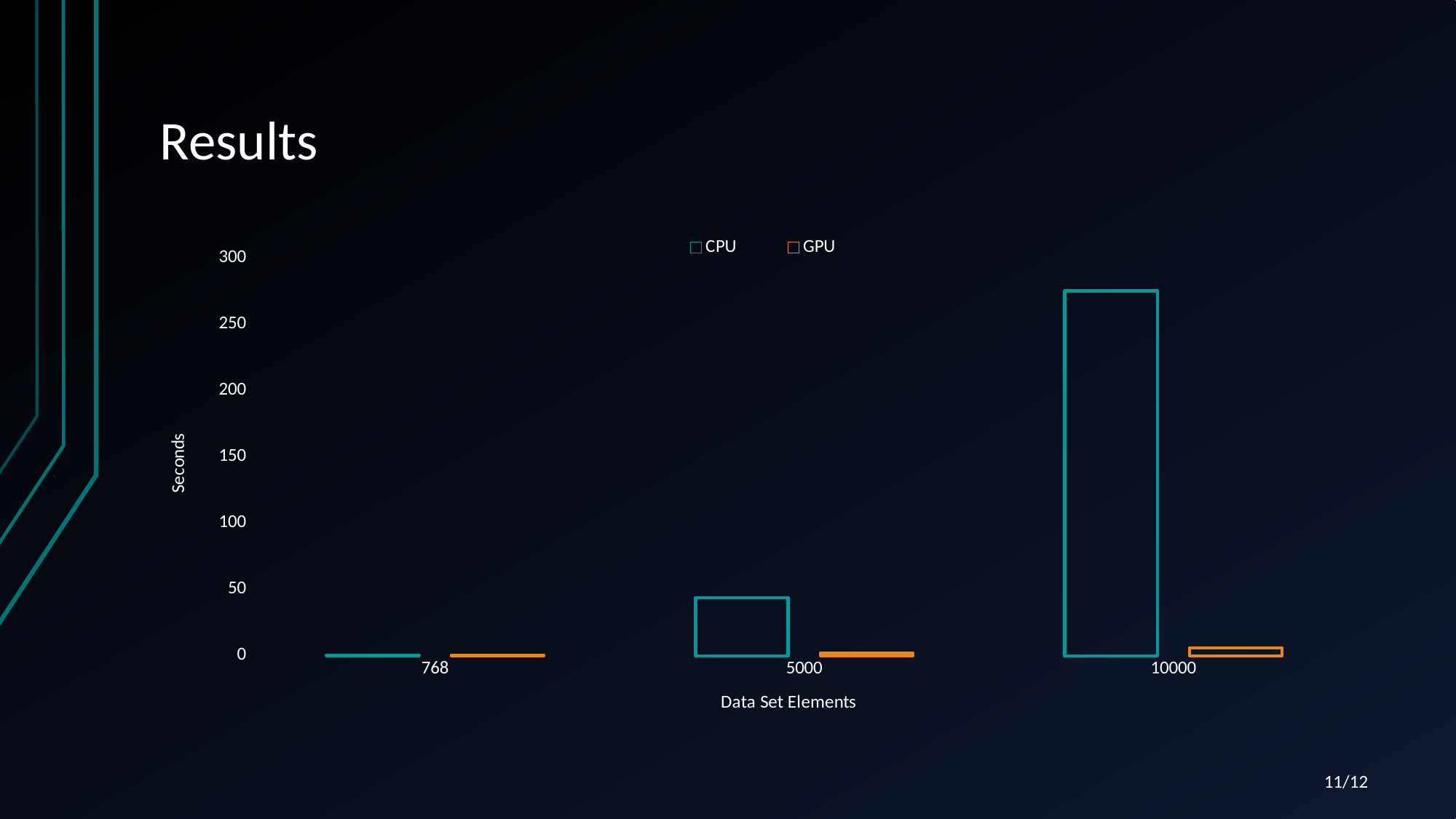
Which data set size has the lowest CPU value? 768 Is the GPU value for 10000 greater or less than 50? less What is the label of the horizontal axis? Data Set Elements How many series does the legend list? 2 Which data set size has the highest CPU value? 10000 Is the CPU value for 5000 greater or less than 50? less What kind of chart is shown on the slide? bar chart How many categories are shown on the x axis? 3 Is the CPU value for 10000 greater or less than 250? greater At 10000 data set elements, which is larger, the CPU value or the GPU value? CPU What is the label of the vertical axis? Seconds Do the CPU values rise or fall as the number of data set elements increases along the x axis? rise